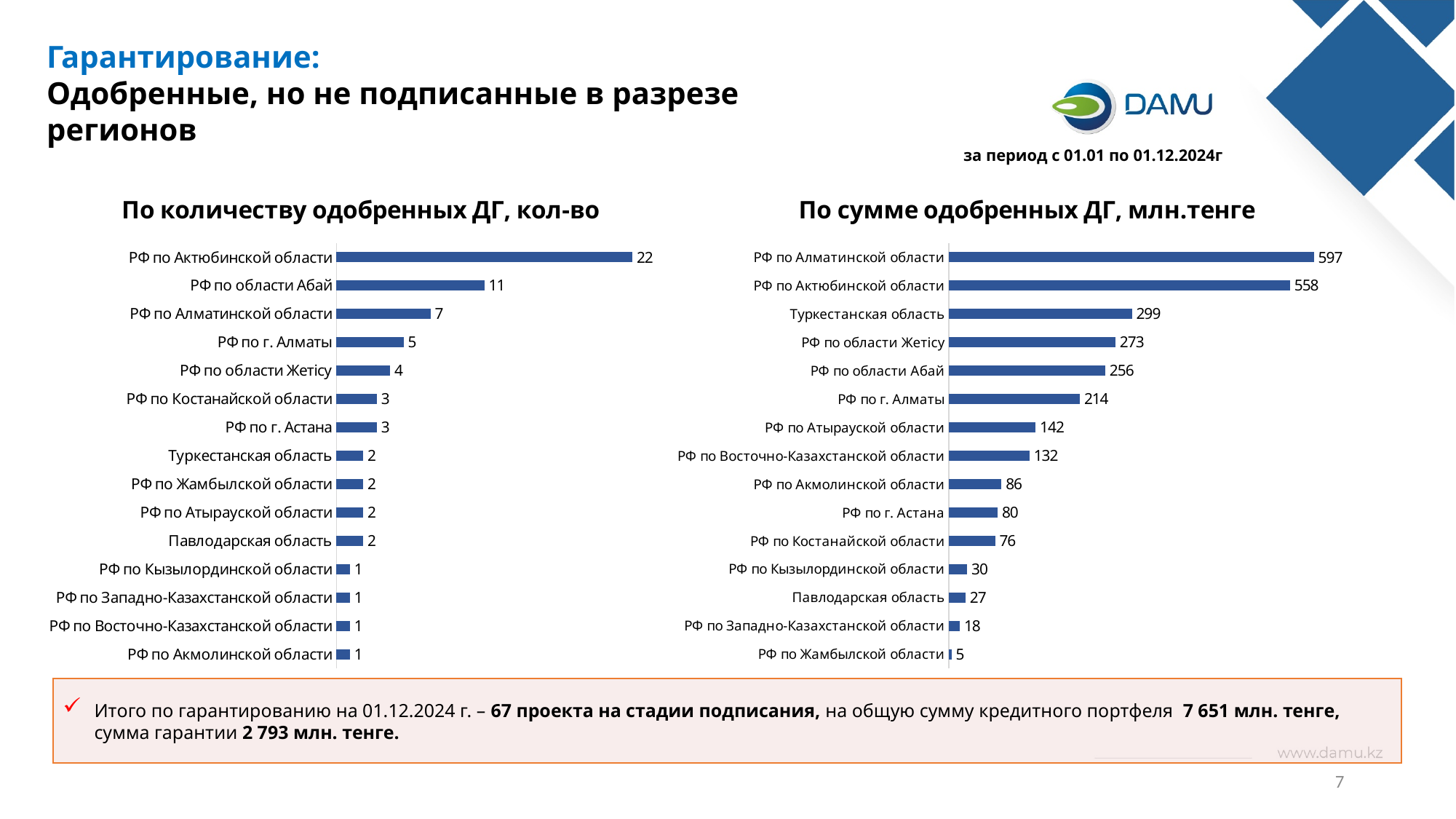
In the chart 'По сумме одобренных ДГ, млн.тенге', what is the difference between РФ по Алматинской области and РФ по Актюбинской области? 39 How many regions are shown in the chart 'По сумме одобренных ДГ, млн.тенге'? 15 In the chart 'По сумме одобренных ДГ, млн.тенге', what is the value for РФ по г. Астана? 80 In the chart 'По сумме одобренных ДГ, млн.тенге', which region has the highest value? РФ по Алматинской области In the chart 'По количеству одобренных ДГ, кол-во', which is larger: РФ по Алматинской области or РФ по г. Алматы? РФ по Алматинской области In the chart 'По количеству одобренных ДГ, кол-во', which region has the highest value? РФ по Актюбинской области In the chart 'По количеству одобренных ДГ, кол-во', what is the difference between РФ по Актюбинской области and РФ по области Абай? 11 In the chart 'По сумме одобренных ДГ, млн.тенге', what is the value for Туркестанская область? 299 In the chart 'По сумме одобренных ДГ, млн.тенге', which region has the lowest value? РФ по Жамбылской области What type of chart is 'По количеству одобренных ДГ, кол-во'? Bar chart In the chart 'По количеству одобренных ДГ, кол-во', what is the value for РФ по Актюбинской области? 22 In the chart 'По сумме одобренных ДГ, млн.тенге', which is larger: РФ по области Жетісу or РФ по области Абай? РФ по области Жетісу